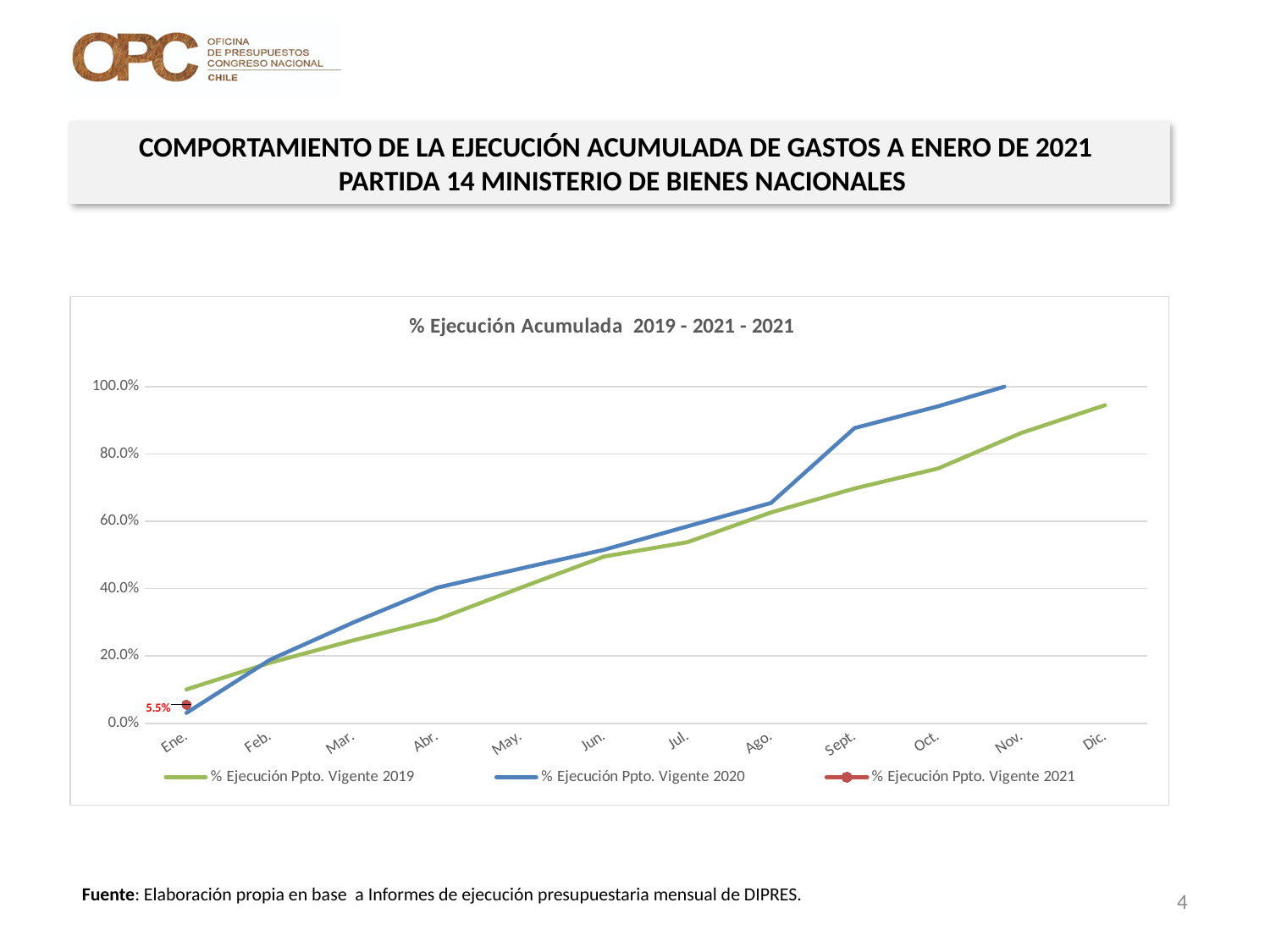
In Ene., which series has the larger value, % Ejecución Ppto. Vigente 2019 or % Ejecución Ppto. Vigente 2020? % Ejecución Ppto. Vigente 2019 Is the value for % Ejecución Ppto. Vigente 2020 in Nov. greater or less than 80.0%? greater In Sept., which series has the larger value, % Ejecución Ppto. Vigente 2019 or % Ejecución Ppto. Vigente 2020? % Ejecución Ppto. Vigente 2020 How many series does the legend list? 3 What is the value of % Ejecución Ppto. Vigente 2021 in Ene.? 5.5% Is the value for % Ejecución Ppto. Vigente 2019 in Ene. greater or less than 20.0%? less Is the value for % Ejecución Ppto. Vigente 2019 in Dic. greater or less than 80.0%? greater How many months are shown on the x axis? 12 What kind of chart is shown on the slide? line chart Do the values of % Ejecución Ppto. Vigente 2019 rise or fall from Ene. to Dic.? rise What is the title of the chart? % Ejecución Acumulada 2019 - 2021 - 2021